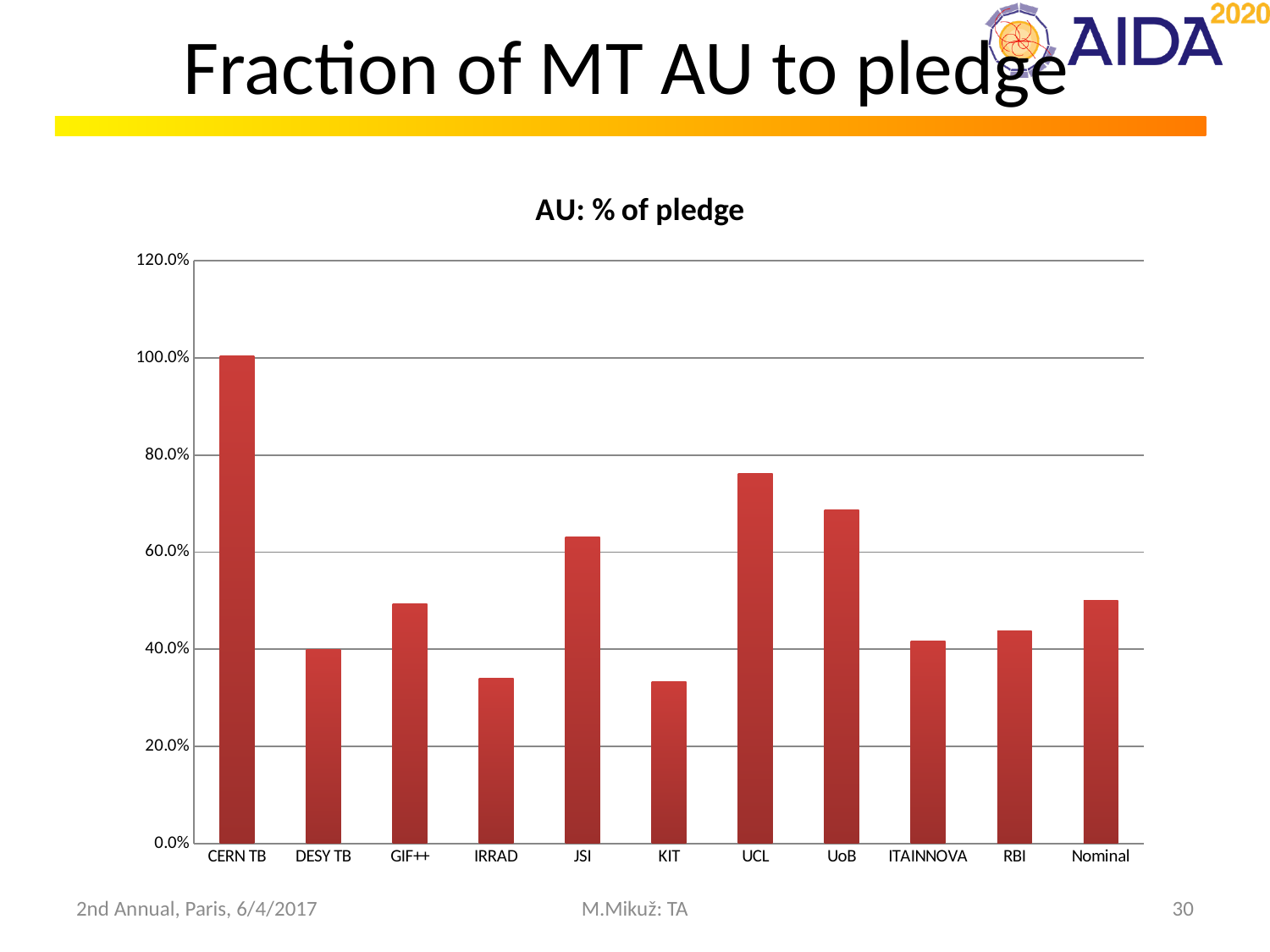
What is the title of the chart? AU: % of pledge What is the highest value shown on the y axis of the chart? 120.0% Is the value for IRRAD greater or less than 40.0%? less Is the value for UoB greater or less than 60.0%? greater Is the value for KIT greater or less than 40.0%? less Which has the larger value, UCL or UoB? UCL Which category has the highest value in the chart? CERN TB How many categories are shown on the x axis of the chart? 11 What type of chart is shown on the slide? bar chart Which has the larger value, JSI or GIF++? JSI